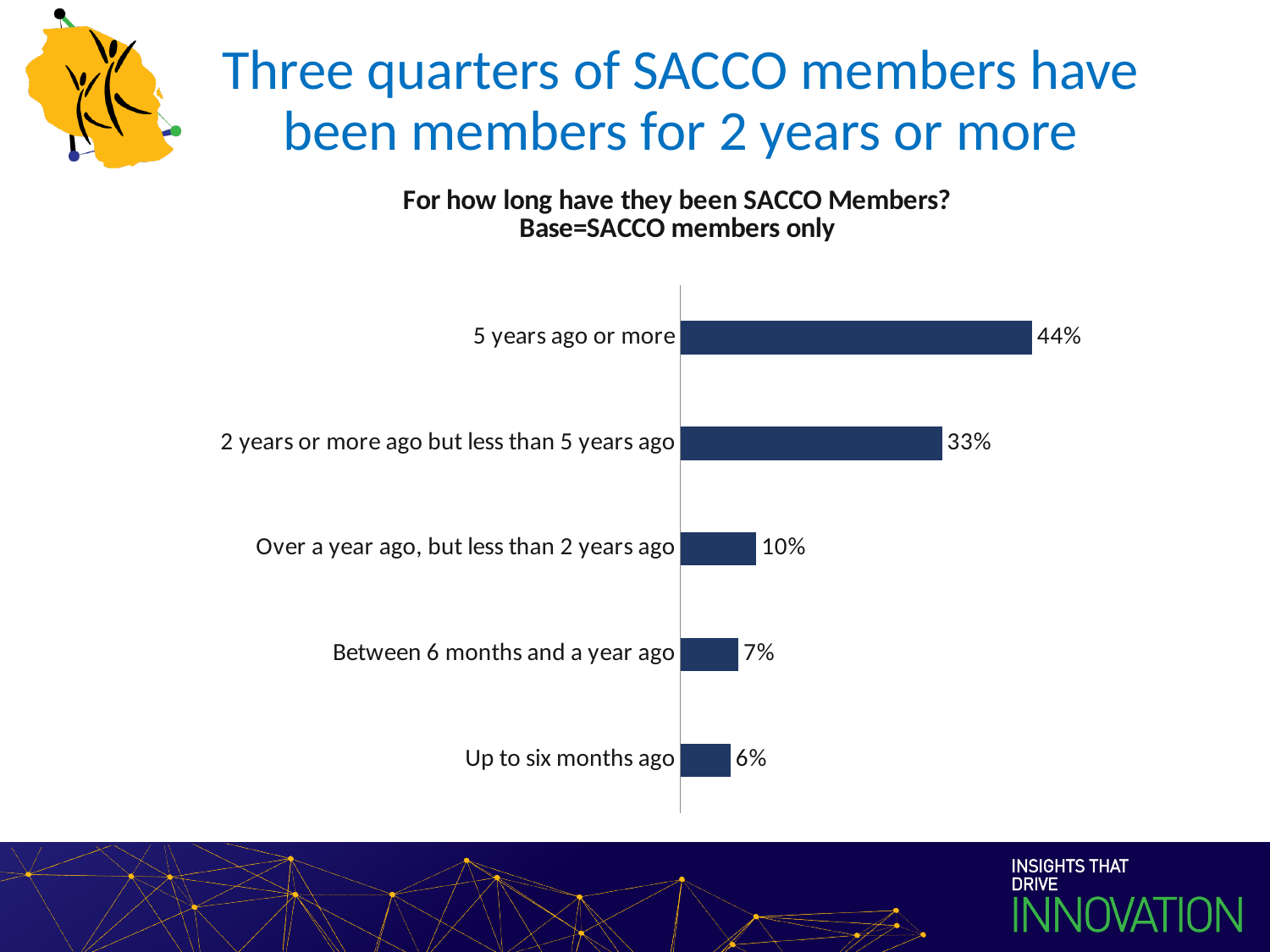
How many categories are shown in the chart? 5 What is the value for '2 years or more ago but less than 5 years ago'? 33% What kind of chart is shown on the slide? Bar chart Which category has the highest value? 5 years ago or more What is the difference between the values for '5 years ago or more' and '2 years or more ago but less than 5 years ago'? 11% What percentage of SACCO members joined 5 years ago or more? 44% Which is larger: the value for 'Over a year ago, but less than 2 years ago' or 'Between 6 months and a year ago'? Over a year ago, but less than 2 years ago Which category has the lowest value? Up to six months ago What is the base stated under the chart's question heading? SACCO members only What is the value for 'Up to six months ago'? 6% What is the combined value for '5 years ago or more' and '2 years or more ago but less than 5 years ago'? 77% What percentage of members joined between 6 months and a year ago? 7%